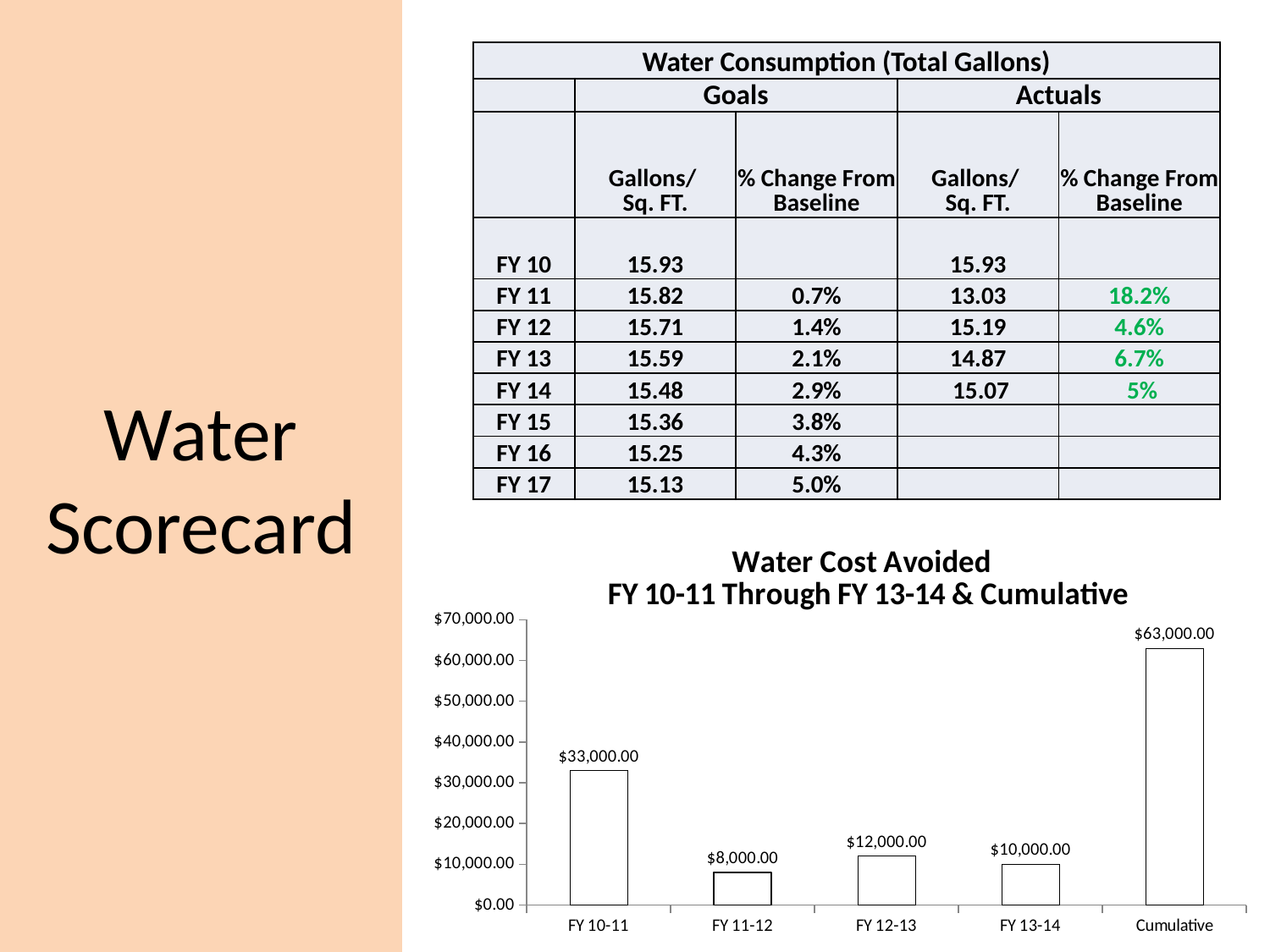
Which is larger in the Water Cost Avoided chart, FY 12-13 or FY 13-14? FY 12-13 What is the value for FY 10-11 in the Water Cost Avoided chart? $33,000.00 What is the value for FY 13-14 in the Water Cost Avoided chart? $10,000.00 How many bars are plotted in the Water Cost Avoided chart? 5 Which category has the highest value in the Water Cost Avoided chart? Cumulative What type of chart is shown on the slide? bar chart What is the value for FY 12-13 in the Water Cost Avoided chart? $12,000.00 Which category has the lowest value in the Water Cost Avoided chart? FY 11-12 What is the title of the chart on the slide? Water Cost Avoided FY 10-11 Through FY 13-14 & Cumulative What is the value for FY 11-12 in the Water Cost Avoided chart? $8,000.00 What is the difference between the FY 10-11 and FY 11-12 values in the Water Cost Avoided chart? $25,000.00 What is the Cumulative value in the Water Cost Avoided chart? $63,000.00